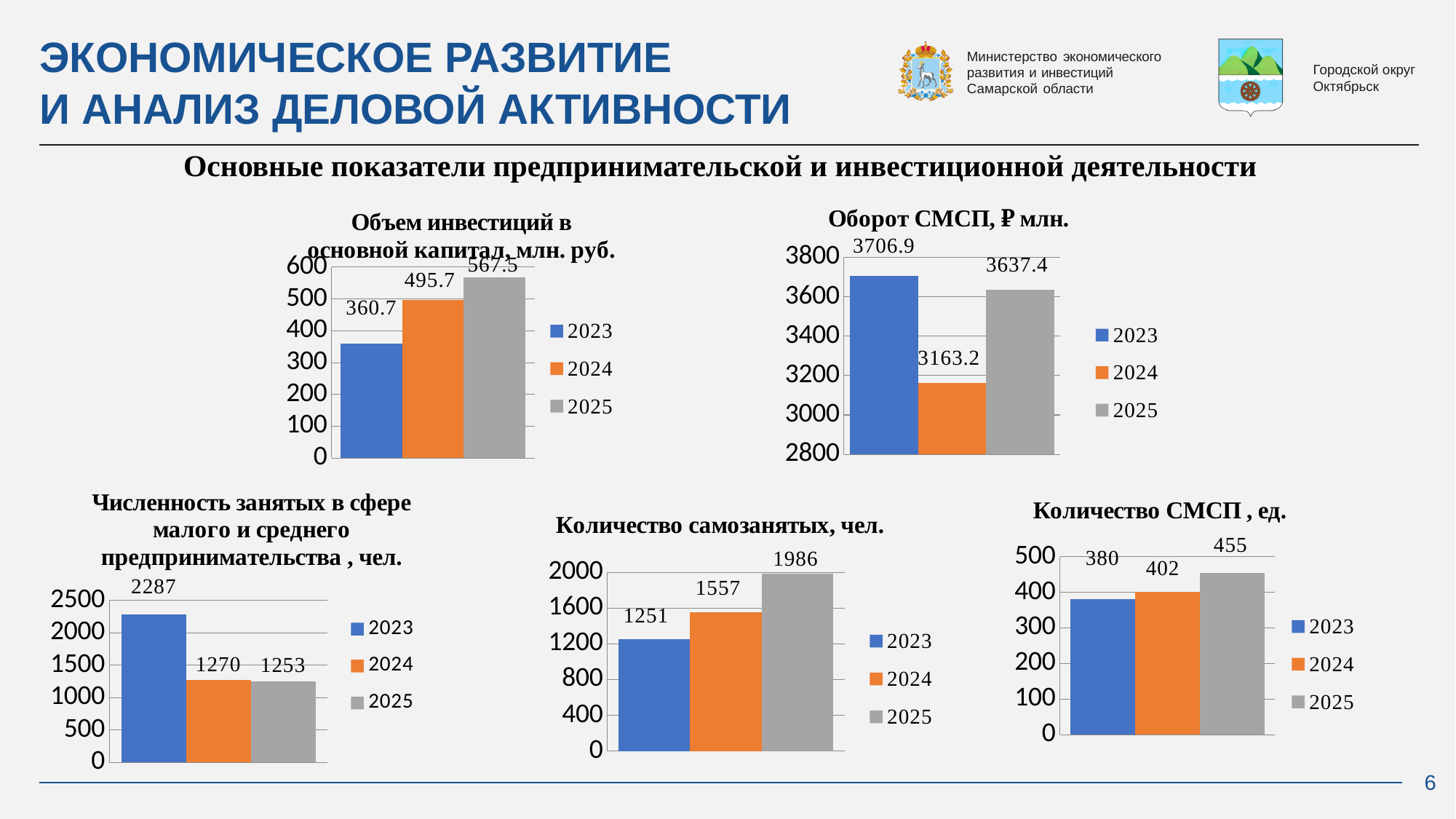
In the chart "Объем инвестиций в основной капитал, млн. руб.", do the values rise or fall from 2023 to 2025? rise In the chart "Оборот СМСП, ₽ млн.", what is the value for 2023? 3706.9 In the chart "Количество СМСП, ед.", which is larger, the value for 2024 or the value for 2025? 2025 In the chart "Численность занятых в сфере малого и среднего предпринимательства, чел.", what is the value for 2023? 2287 In the chart "Объем инвестиций в основной капитал, млн. руб.", what is the value for 2024? 495.7 In the chart "Оборот СМСП, ₽ млн.", what is the difference between the 2023 and 2025 values? 69.5 In the chart "Оборот СМСП, ₽ млн.", which year has the lowest value? 2024 In the chart "Количество самозанятых, чел.", what is the difference between the 2025 and 2023 values? 735 What type of chart is "Количество самозанятых, чел."? bar chart In the chart "Численность занятых в сфере малого и среднего предпринимательства, чел.", which year has the highest value? 2023 In the chart "Количество самозанятых, чел.", what is the value for 2025? 1986 In the chart "Количество СМСП, ед.", how many series does the legend list? 3